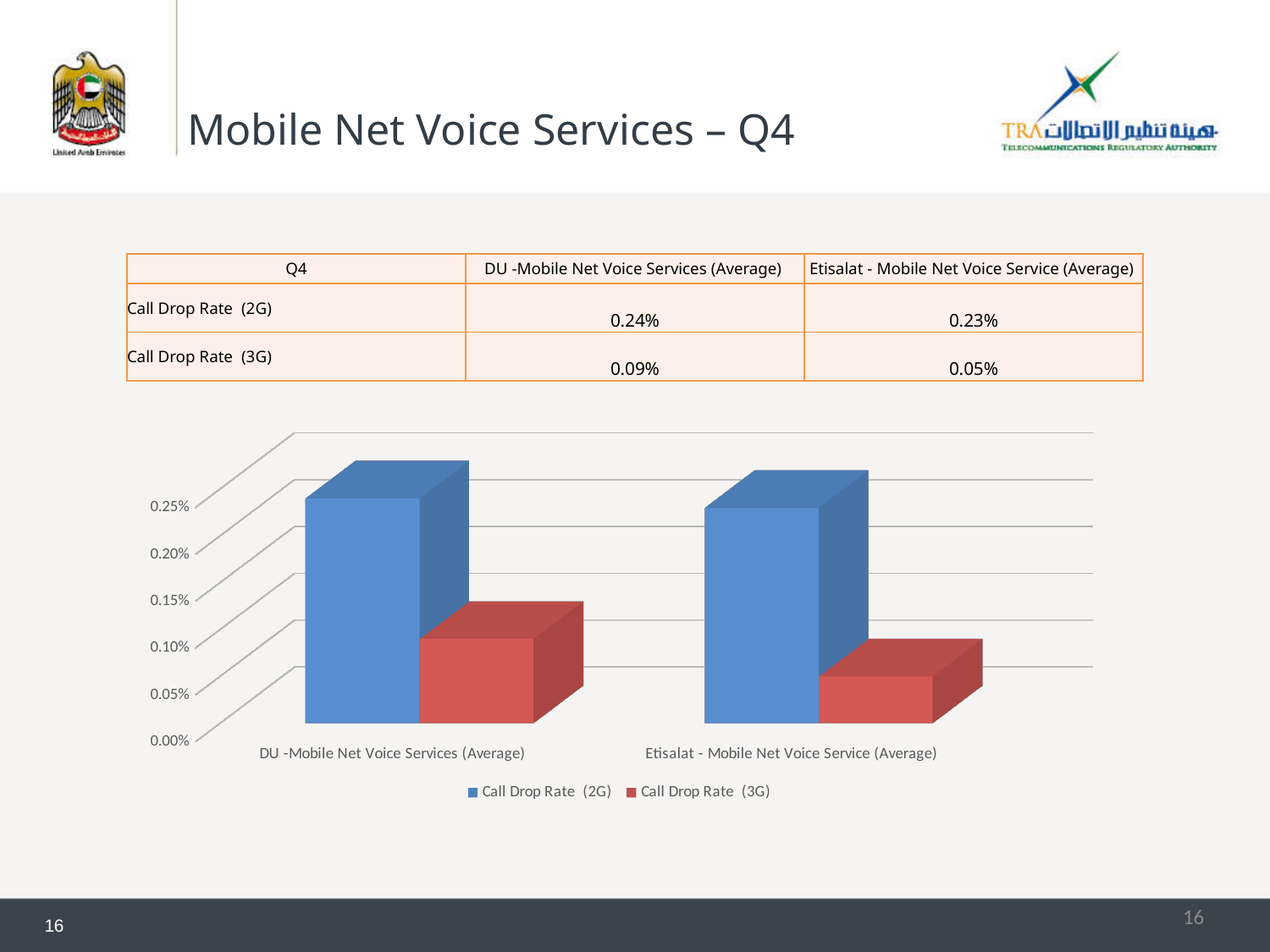
How many series does the chart legend list? 2 What kind of chart is shown on the slide? bar chart What is the Call Drop Rate (2G) for DU - Mobile Net Voice Services (Average)? 0.24% What is the difference between the Call Drop Rate (2G) and Call Drop Rate (3G) for DU? 0.15% Which series is shown in red in the chart? Call Drop Rate (3G) How many categories are shown on the x axis of the chart? 2 What is the Call Drop Rate (3G) for DU - Mobile Net Voice Services (Average)? 0.09% What is the Call Drop Rate (3G) for Etisalat - Mobile Net Voice Service (Average)? 0.05% What is the difference between the Call Drop Rate (3G) for DU and for Etisalat? 0.04% Is the Call Drop Rate (2G) for Etisalat greater or less than 0.15%? greater Which operator has the higher Call Drop Rate (3G)? DU - Mobile Net Voice Services (Average) Which series has the lowest value in the chart? Call Drop Rate (3G) for Etisalat - Mobile Net Voice Service (Average)